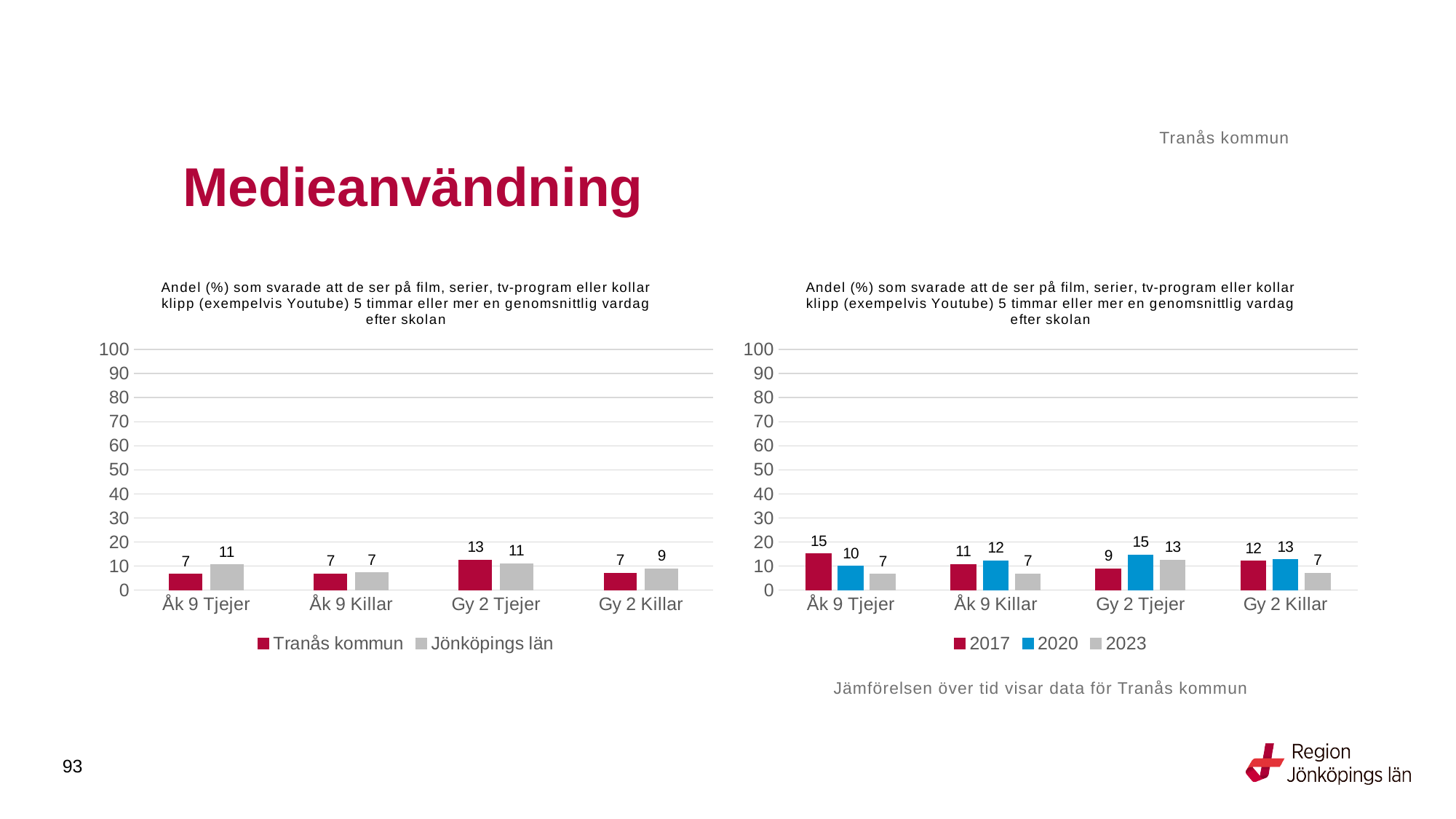
In the left chart, what is the value for Tranås kommun for Gy 2 Tjejer? 13 In the right chart, how many series does the legend list? 3 In the right chart, which is larger for Åk 9 Tjejer: 2017 or 2023? 2017 In the right chart, what is the value for 2023 for Gy 2 Killar? 7 In the left chart, what is the difference between Jönköpings län and Tranås kommun for Åk 9 Tjejer? 4 In the left chart, which category has the highest value for Tranås kommun? Gy 2 Tjejer In the right chart, what is the difference between 2017 and 2023 for Åk 9 Tjejer? 8 In the right chart, what is the value for 2020 for Gy 2 Tjejer? 15 In the right chart, which category has the highest value for 2017? Åk 9 Tjejer What kind of chart is the right chart? Bar chart In the left chart, what is the value for Jönköpings län for Åk 9 Tjejer? 11 In the left chart, how many series does the legend list? 2